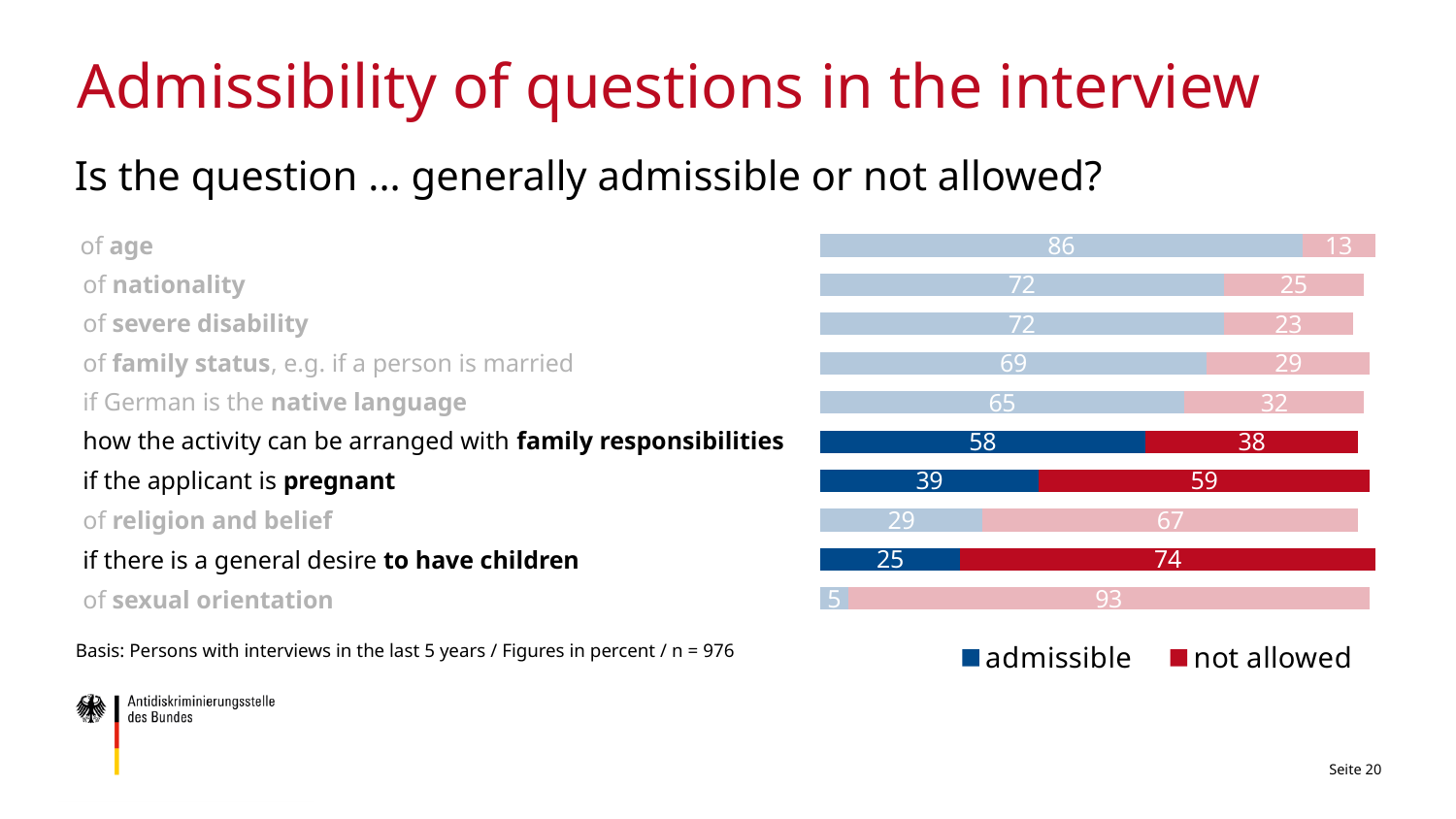
Which category has the highest 'admissible' value? of age What percentage of respondents consider a question about age admissible? 86 What is the total of the 'admissible' and 'not allowed' values for the question of nationality? 97 Which is larger: the 'admissible' value for family responsibilities or for native language? native language How many series does the legend list? 2 Which category has the lowest 'admissible' value? of sexual orientation What is the difference between the 'not allowed' values for 'to have children' and 'religion and belief'? 7 What is the 'not allowed' value for the question of sexual orientation? 93 What kind of chart is shown on the slide? stacked bar chart Which series is shown in red in the legend? not allowed What is the 'admissible' value for the question if the applicant is pregnant? 39 How many categories (questions) are shown in the chart? 10